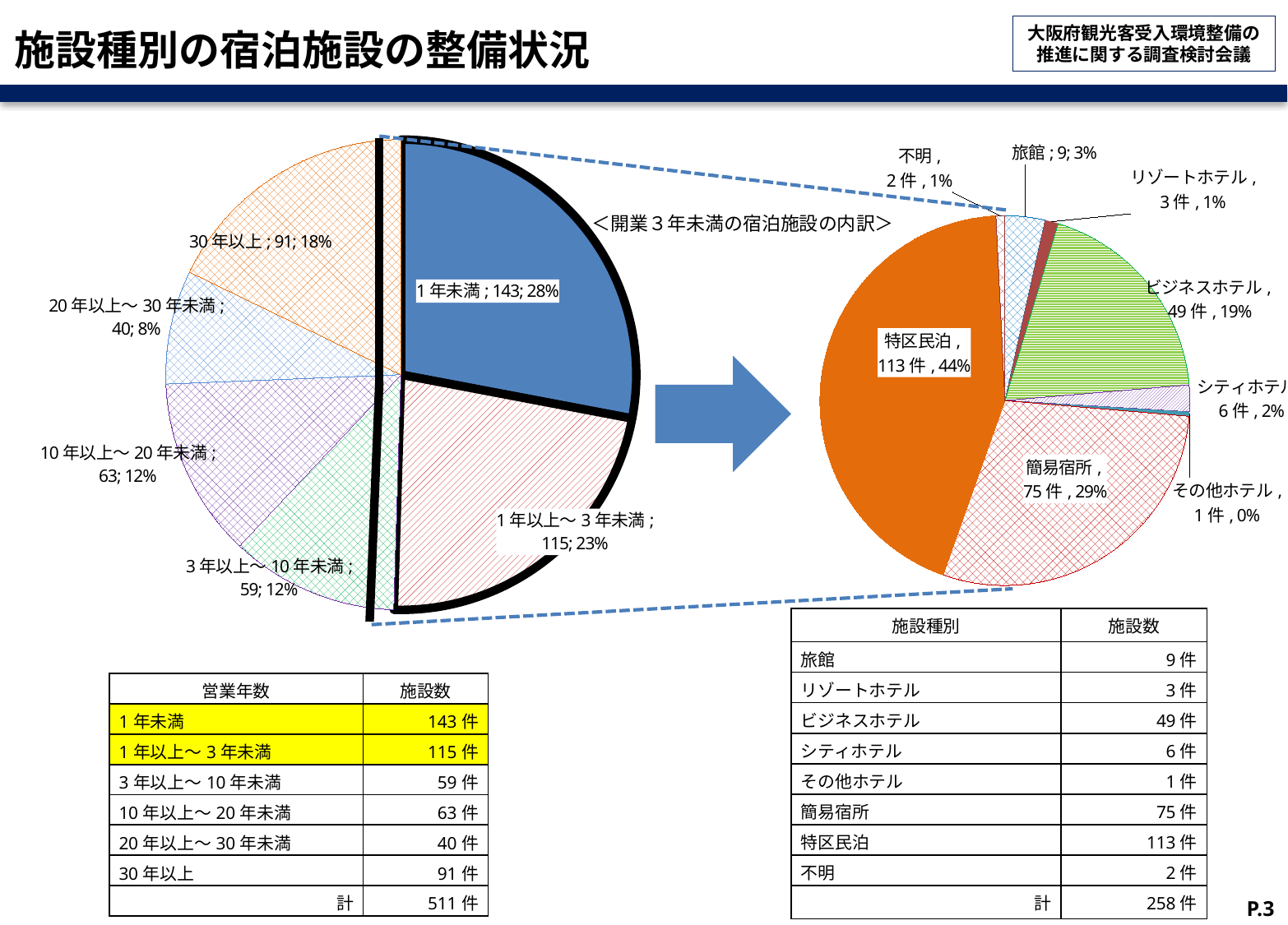
In the right pie chart (開業3年未満の宿泊施設の内訳), what share of the pie does 簡易宿所 represent? 29% In the right pie chart (開業3年未満の宿泊施設の内訳), what is the value for ビジネスホテル? 49件, 19% In the left pie chart, what is the value for 30年以上? 91; 18% In the left pie chart, what is the value for 1年未満? 143; 28% In the right pie chart (開業3年未満の宿泊施設の内訳), which category has the smallest slice? その他ホテル In the left pie chart, what is the difference between the values for 1年未満 and 1年以上～3年未満? 28 In the left pie chart, which category has the largest slice? 1年未満 In the right pie chart (開業3年未満の宿泊施設の内訳), what is the value for 特区民泊? 113件, 44% In the left pie chart, which category has the smallest slice? 20年以上～30年未満 In the right pie chart (開業3年未満の宿泊施設の内訳), which is larger, 簡易宿所 or ビジネスホテル? 簡易宿所 In the left pie chart, how many categories are shown? 6 What type of chart is used on the left side of the slide? Pie chart